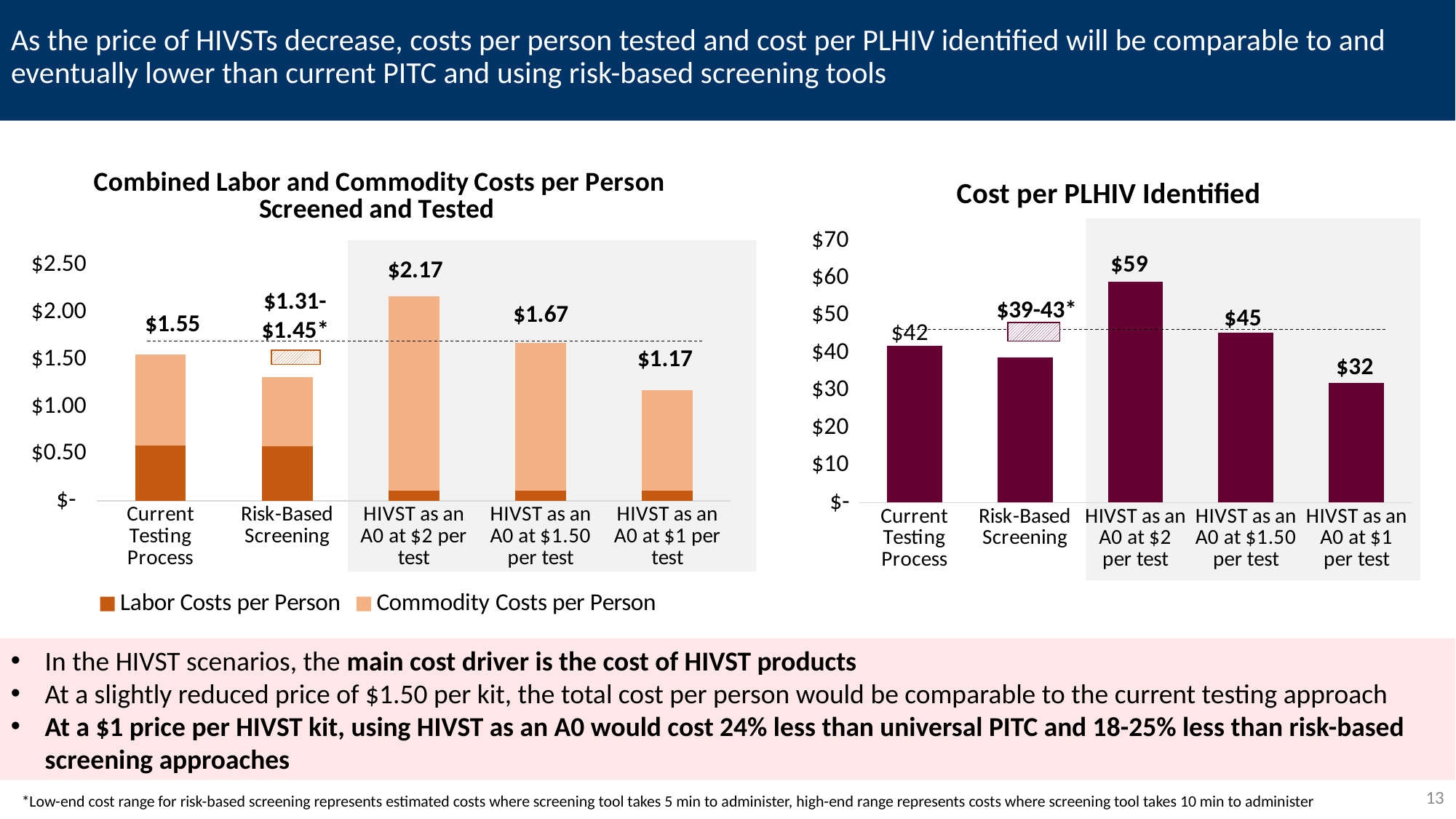
In the 'Combined Labor and Commodity Costs per Person Screened and Tested' chart, how much higher is the total for HIVST as an A0 at $2 per test than for the Current Testing Process? $0.62 In the 'Combined Labor and Commodity Costs per Person Screened and Tested' chart, which category has the highest total cost? HIVST as an A0 at $2 per test In the 'Cost per PLHIV Identified' chart, which category has the highest cost? HIVST as an A0 at $2 per test In the 'Combined Labor and Commodity Costs per Person Screened and Tested' chart, which category has the lowest total cost? HIVST as an A0 at $1 per test In the 'Cost per PLHIV Identified' chart, what is the difference between the cost for HIVST as an A0 at $2 per test and HIVST as an A0 at $1 per test? $27 In the 'Combined Labor and Commodity Costs per Person Screened and Tested' chart, what is the total cost for HIVST as an A0 at $1.50 per test? $1.67 How many categories are shown on the x axis of the 'Cost per PLHIV Identified' chart? 5 In the 'Combined Labor and Commodity Costs per Person Screened and Tested' chart, what is the total cost for the Current Testing Process? $1.55 In the 'Combined Labor and Commodity Costs per Person Screened and Tested' chart, is the labor cost per person for the Current Testing Process greater or less than $1.00? less In the 'Cost per PLHIV Identified' chart, which is larger: the cost for the Current Testing Process or for HIVST as an A0 at $1.50 per test? HIVST as an A0 at $1.50 per test In the 'Cost per PLHIV Identified' chart, what is the cost for HIVST as an A0 at $1 per test? $32 How many series does the legend of the 'Combined Labor and Commodity Costs per Person Screened and Tested' chart list? 2